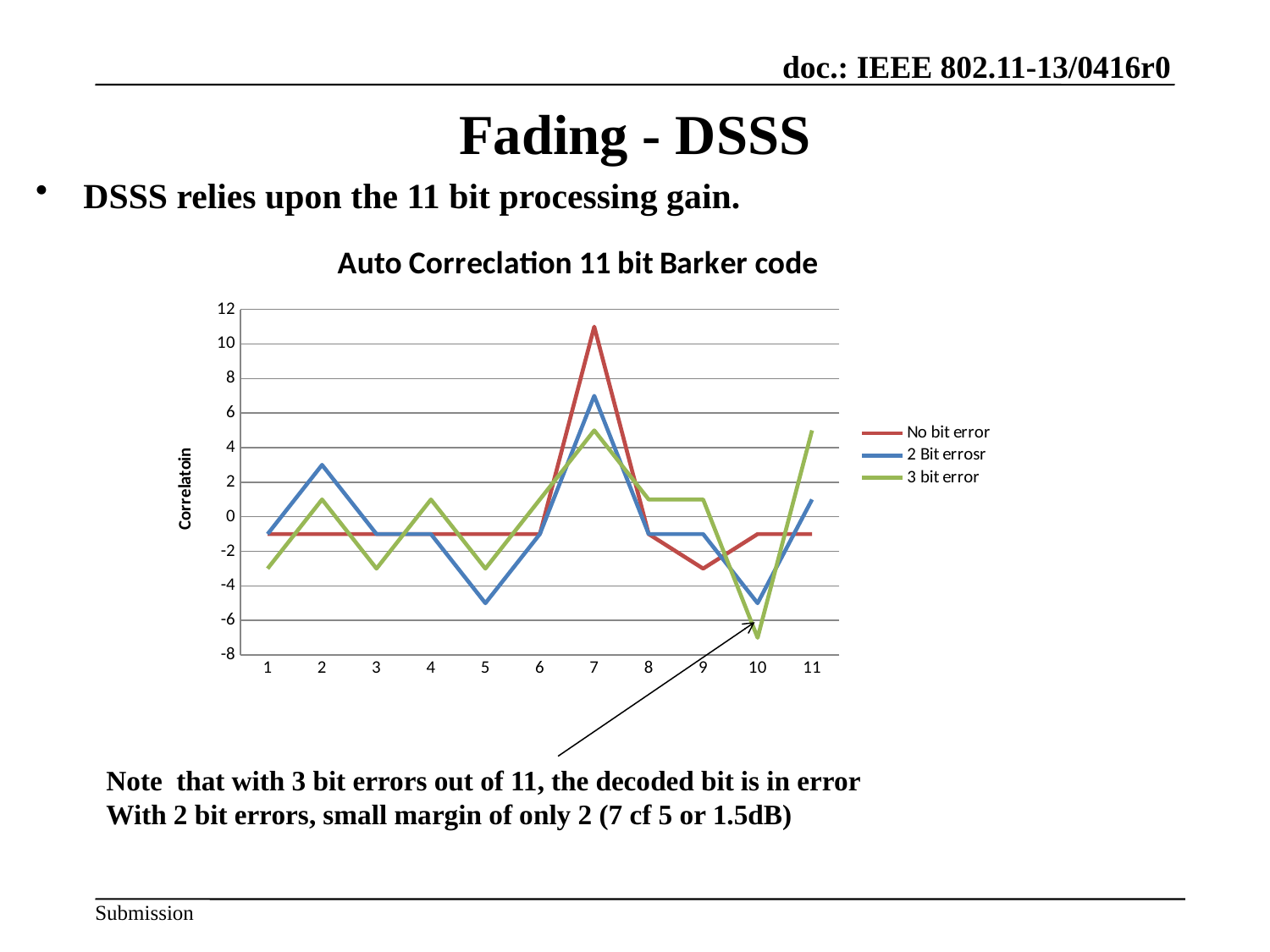
Is the value of the 3 bit error series at x = 10 greater or less than -6? less How many series does the legend list? 3 At which x-axis position does the No bit error series reach its highest value? 7 At x = 2, which series has the larger value: 2 Bit errosr or 3 bit error? 2 Bit errosr At x = 7, which series has the larger value: No bit error or 2 Bit errosr? No bit error What is the title of the chart? Auto Correclation 11 bit Barker code What kind of chart is shown on the slide? line chart At x = 10, which series has the lowest value? 3 bit error Is the value of the No bit error series at x = 7 greater or less than 10? greater Does the No bit error series rise or fall from x = 8 to x = 9? fall Is the value of the 2 Bit errosr series at x = 5 greater or less than -4? less How many points are plotted along the x axis for each series? 11